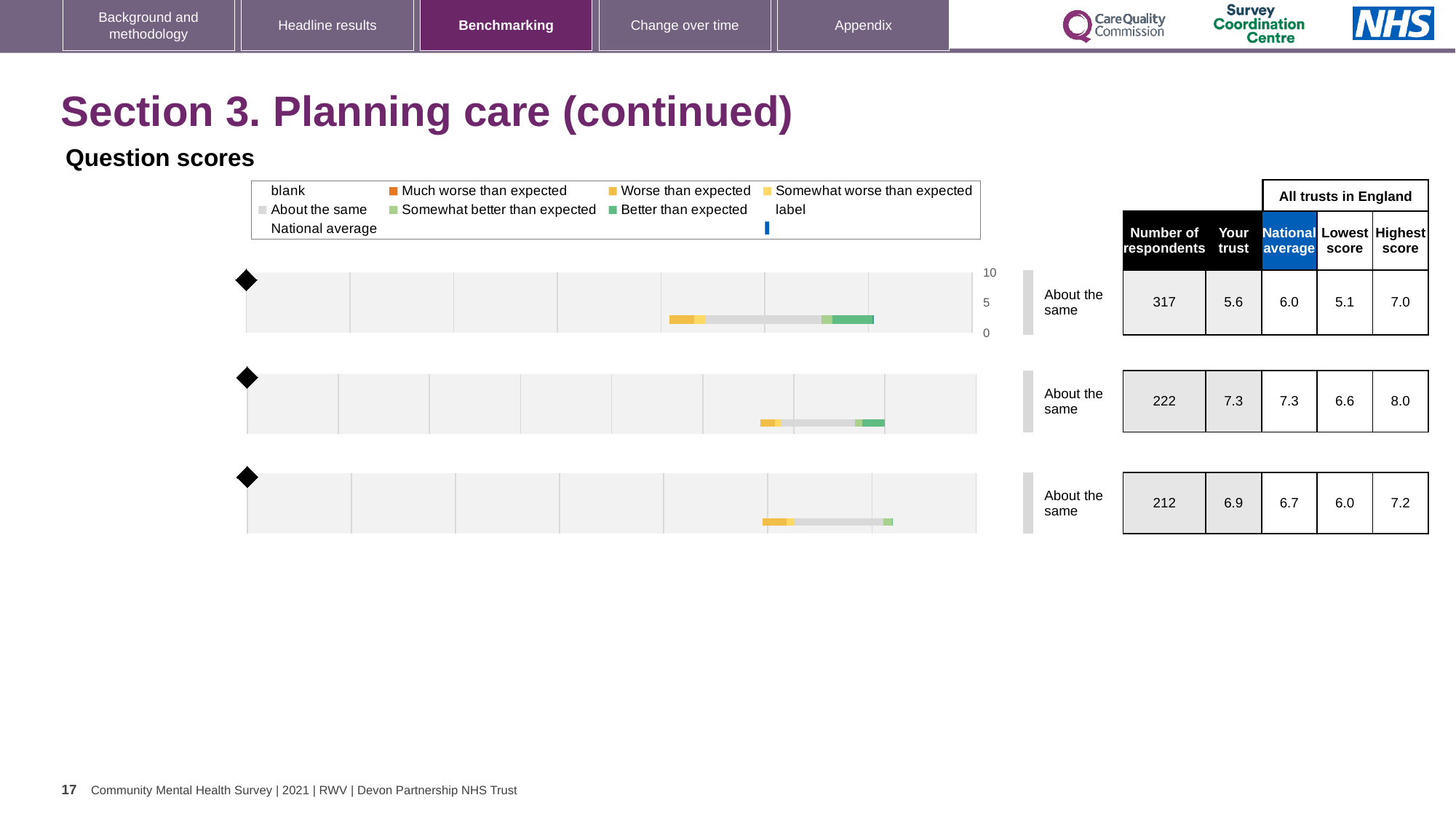
What benchmark category is shown next to the middle chart? About the same What kind of chart is used for the three benchmarking charts on the slide? Bar chart For the top chart, what is the difference between the highest score and the lowest score? 1.9 For the top chart, what is the number of respondents? 317 In the legend, what colour represents 'Much worse than expected'? Orange For the bottom chart, is the 'Your trust' score or the national average score larger? Your trust For the top chart, what is the 'Your trust' score in the table? 5.6 For the middle chart, what is the national average score? 7.3 How many benchmarking charts are shown on the slide? 3 Which of the three charts has the largest number of respondents? The top chart What is the maximum value shown on the score axis of the top chart? 10 For the bottom chart, what is the highest score among all trusts in England? 7.2